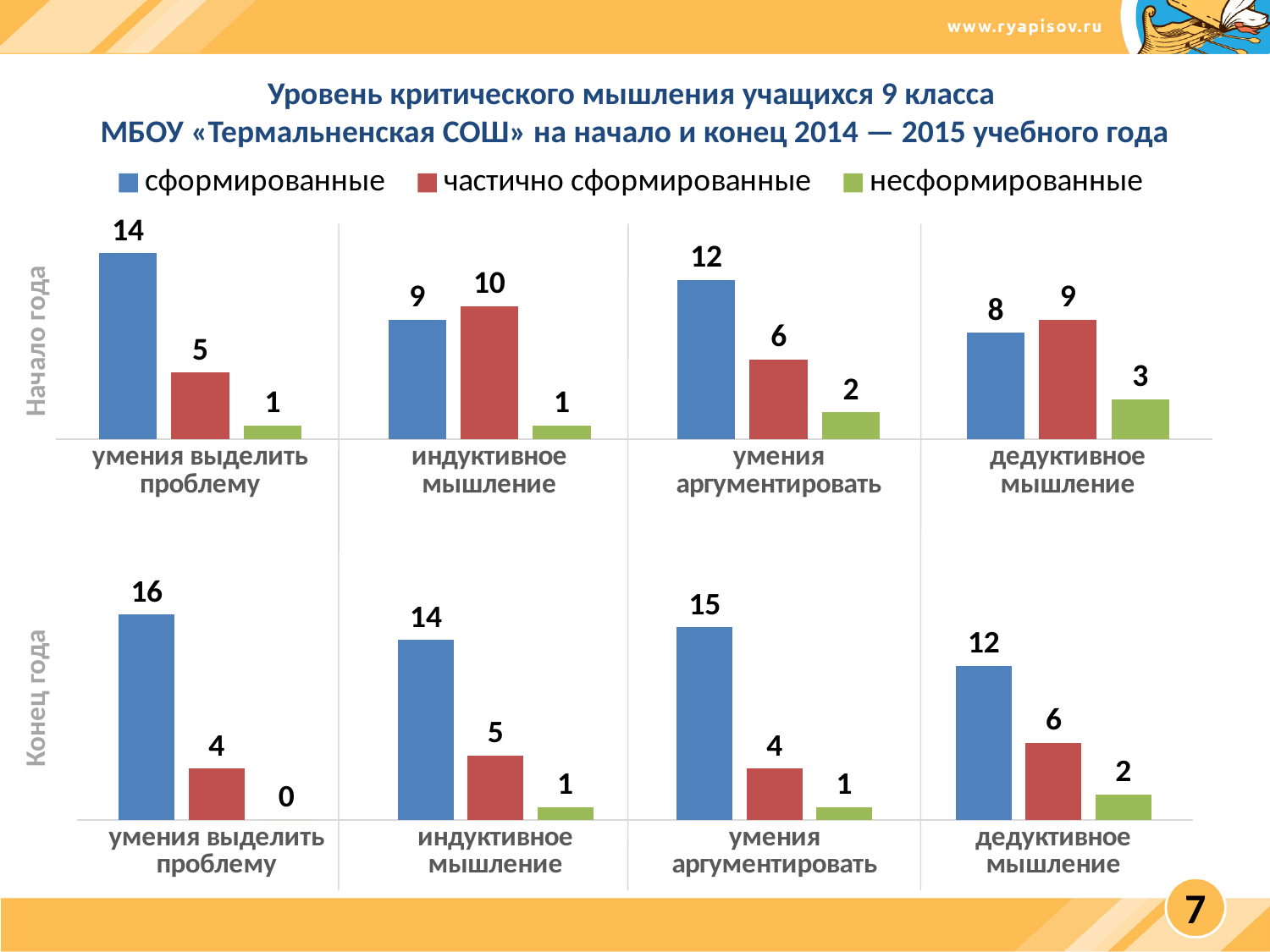
In the 'Начало года' chart, which is larger in 'индуктивное мышление': 'сформированные' or 'частично сформированные'? частично сформированные In the 'Начало года' chart, which category has the lowest value for 'сформированные'? дедуктивное мышление In the 'Конец года' chart, which category has the highest value for 'сформированные'? умения выделить проблему In the 'Начало года' chart, what is the difference between 'сформированные' and 'частично сформированные' in 'умения аргументировать'? 6 How many categories are shown on the x axis of the 'Конец года' chart? 4 In the 'Начало года' chart, what is the value for 'сформированные' in 'умения выделить проблему'? 14 In the 'Конец года' chart, what is the difference between 'сформированные' and 'частично сформированные' in 'индуктивное мышление'? 9 In the 'Конец года' chart, what is the value for 'частично сформированные' in 'дедуктивное мышление'? 6 How many series does the legend list? 3 In the 'Начало года' chart, what is the value for 'несформированные' in 'дедуктивное мышление'? 3 What kind of chart is the 'Начало года' chart? bar chart In the 'Конец года' chart, what is the total of the three series for 'умения аргументировать'? 20